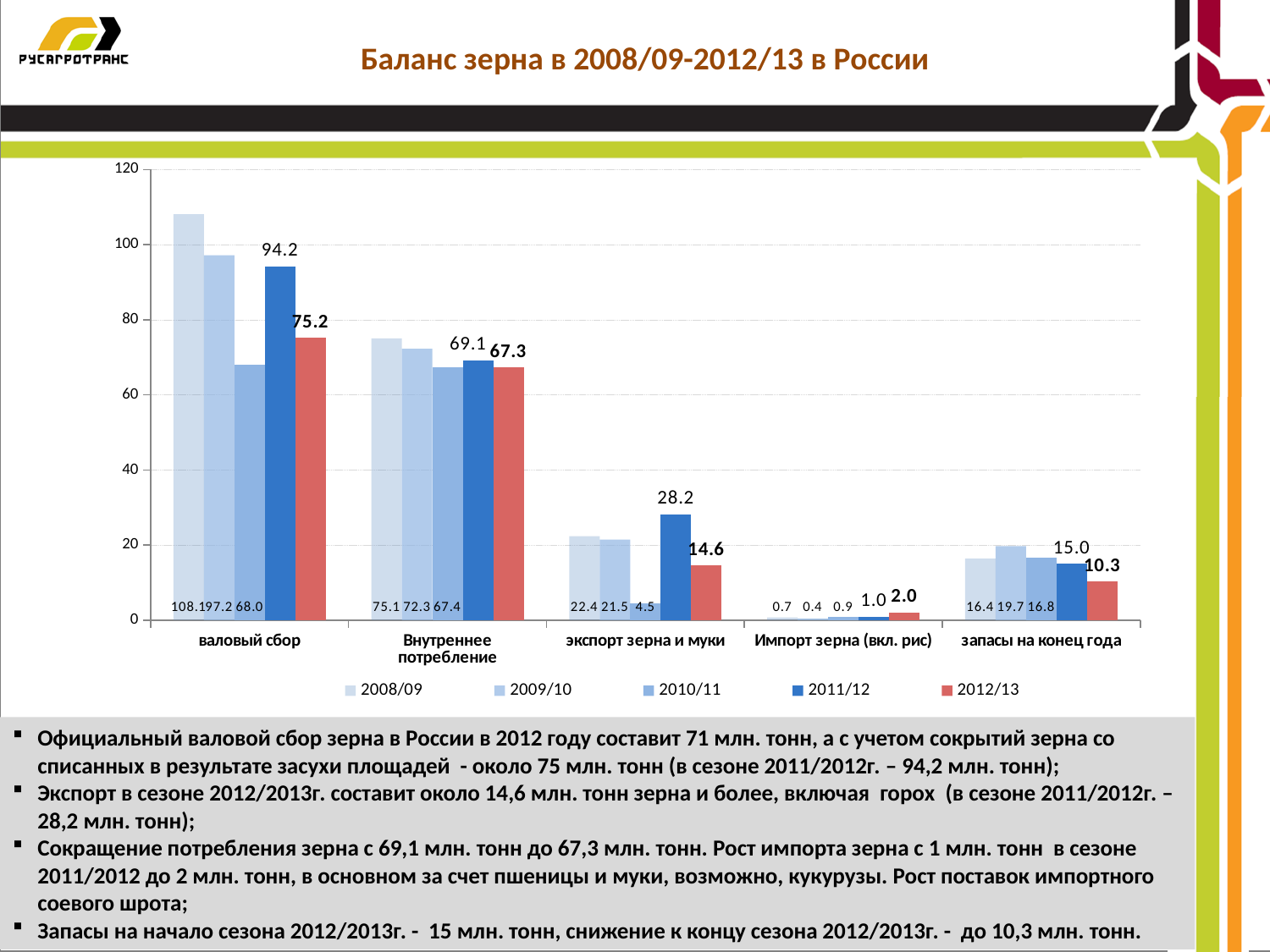
What is the difference between the 2011/12 and 2012/13 values in the category 'валовый сбор'? 19.0 Which season has the lowest value in the category 'Импорт зерна (вкл. рис)'? 2009/10 Which is larger in the category 'Внутреннее потребление': the value for 2008/09 or the value for 2012/13? 2008/09 What is the title of the chart on the slide? Баланс зерна в 2008/09-2012/13 в России What is the value for 2009/10 in the category 'запасы на конец года'? 19.7 How many categories are shown on the x axis? 5 What is the value for 2011/12 in the category 'валовый сбор'? 94.2 What type of chart is shown on the slide? bar chart Which season has the highest value in the category 'валовый сбор'? 2008/09 What is the value for 2012/13 in the category 'экспорт зерна и муки'? 14.6 How many series does the legend list? 5 Is the value for 2010/11 in the category 'валовый сбор' greater or less than 80? less